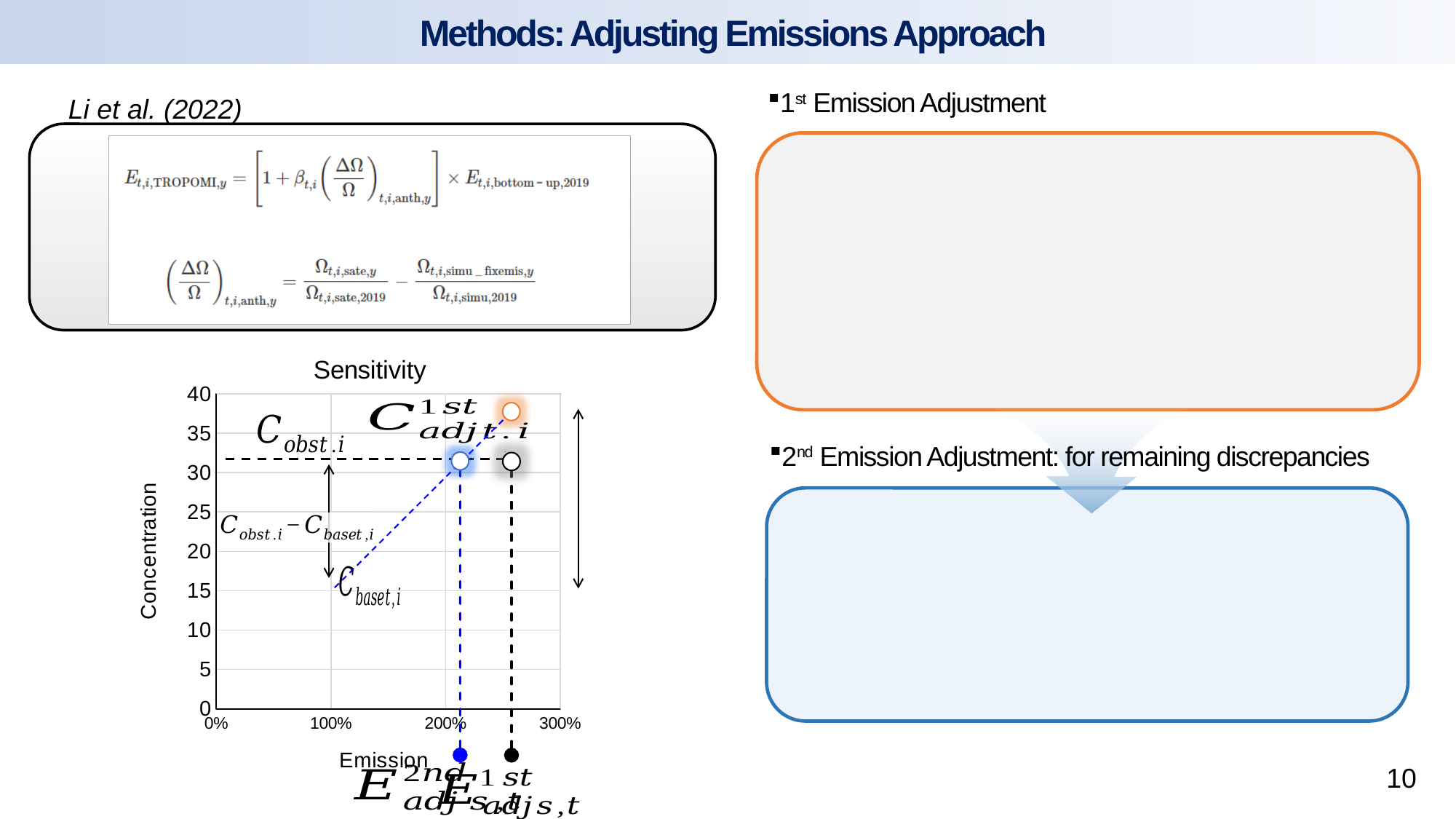
On the 'Sensitivity' chart, is the concentration of the blue point greater or less than 35? less On the 'Sensitivity' chart, which point has a higher emission value, the blue point or the black point? black On the 'Sensitivity' chart, is the emission value of the black point greater or less than 300%? less What is the title of the chart on the left of the slide? Sensitivity On the 'Sensitivity' chart, is the emission value of the blue point greater or less than 100%? greater How many circular data points are plotted on the 'Sensitivity' chart? 3 What is the highest tick value shown on the y axis of the 'Sensitivity' chart? 40 What is the label of the y axis of the 'Sensitivity' chart? Concentration On the 'Sensitivity' chart, which point has the highest concentration: the orange, blue or black point? orange What kind of chart is the 'Sensitivity' chart on the slide? scatter chart